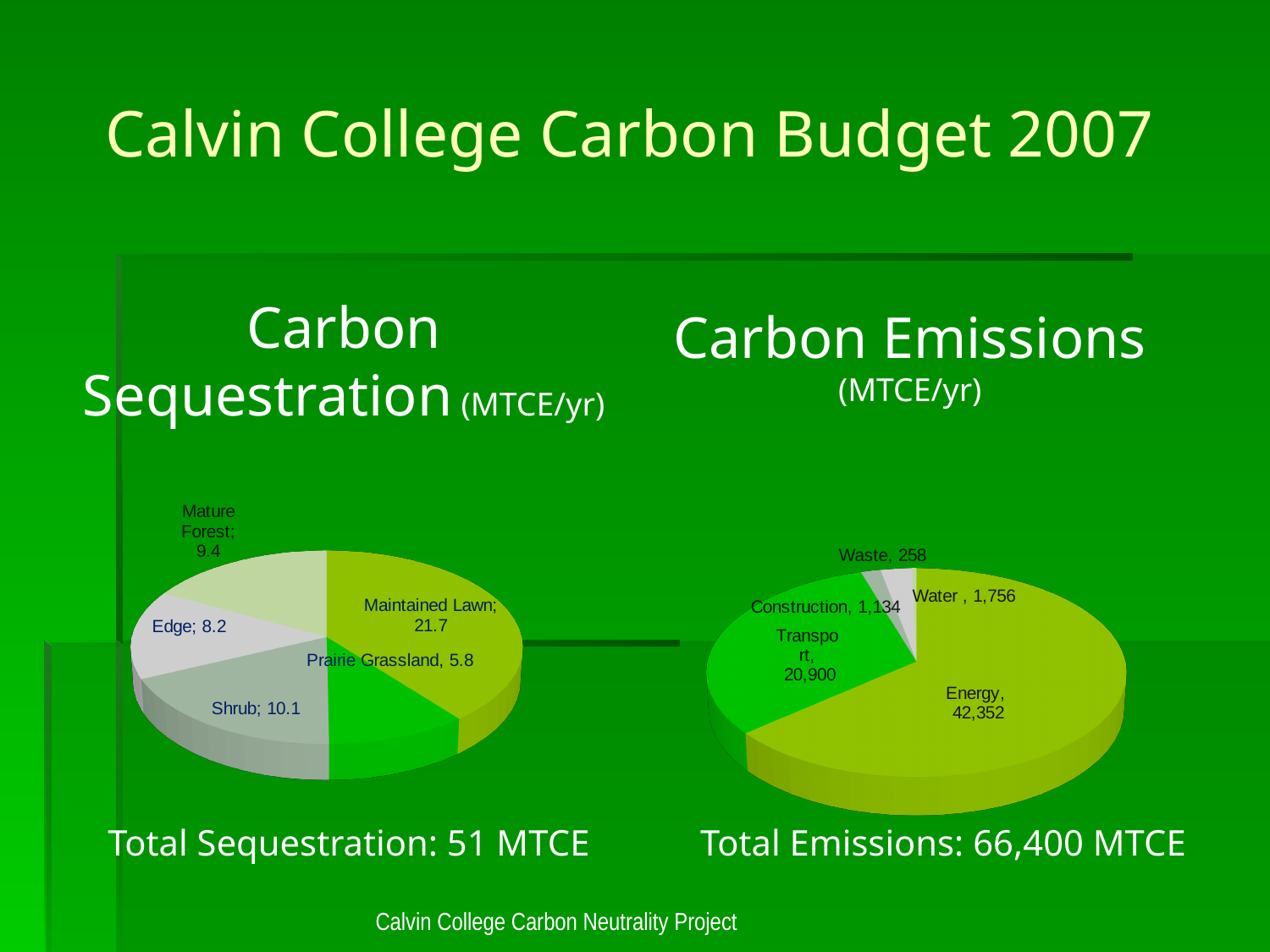
What total emissions figure is stated below the Carbon Emissions chart? 66,400 MTCE In the Carbon Emissions chart, what is the value for Energy? 42,352 In the Carbon Sequestration chart, how many categories are shown? 5 What kind of chart is the Carbon Sequestration chart on the left? Pie chart In the Carbon Emissions chart, what is the value for Waste? 258 In the Carbon Sequestration chart, what is the value for Maintained Lawn? 21.7 In the Carbon Emissions chart, what is the difference between Energy and Transport? 21,452 In the Carbon Emissions chart, which is larger, Water or Construction? Water In the Carbon Sequestration chart, what is the value for Shrub? 10.1 In the Carbon Sequestration chart, what is the difference between Maintained Lawn and Shrub? 11.6 In the Carbon Sequestration chart, which category has the smallest value? Prairie Grassland In the Carbon Sequestration chart, which category has the largest value? Maintained Lawn